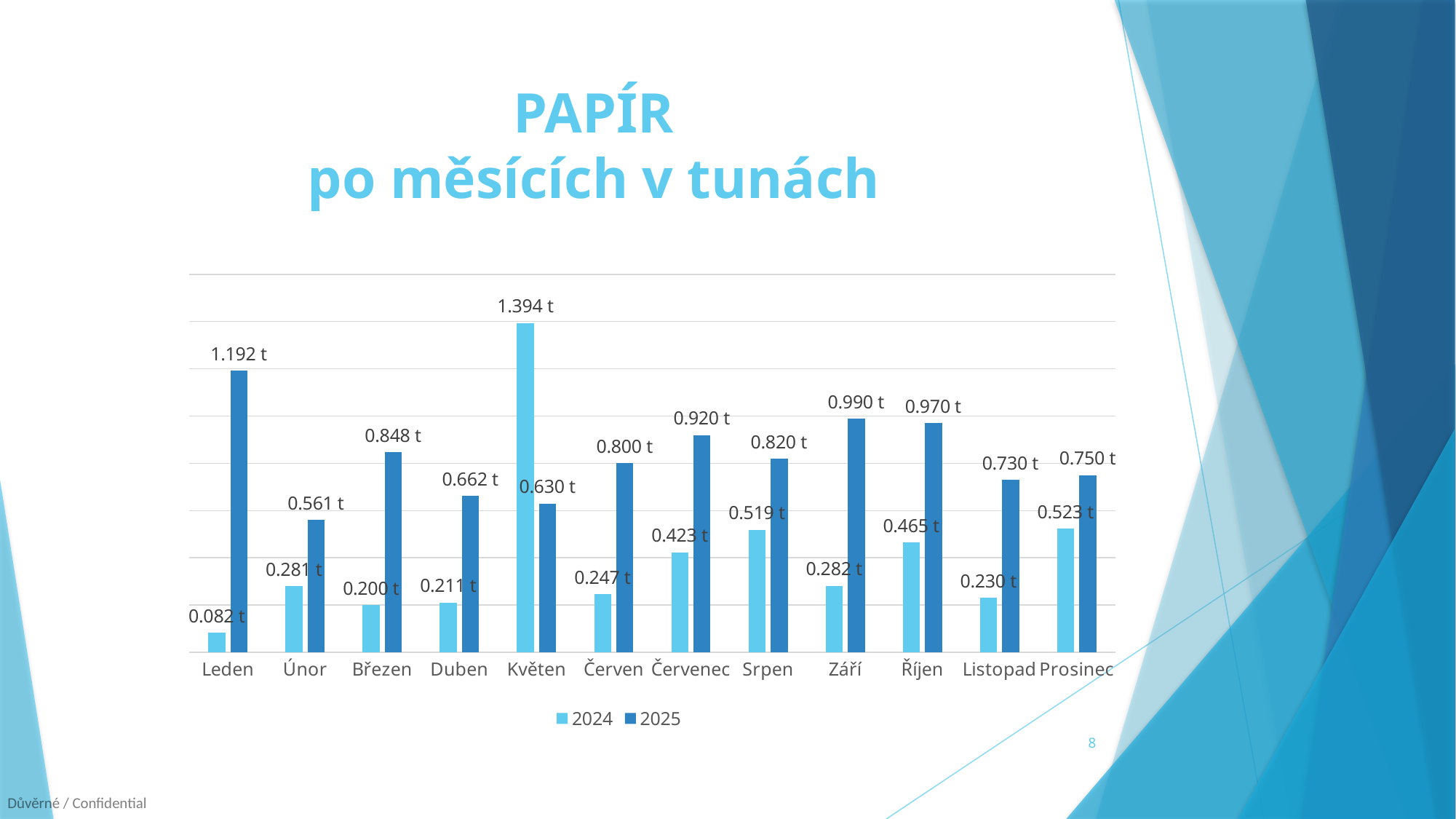
Which month has the lowest value in the 2024 series? Leden Which month has the lowest value in the 2025 series? Únor How many series does the legend list? 2 How many months are shown on the x axis? 12 What is the value for Květen in the 2024 series? 1.394 t Which month has the highest value in the 2024 series? Květen Which is larger for Květen: the 2024 value or the 2025 value? 2024 What is the value for Září in the 2025 series? 0.990 t Which month has the highest value in the 2025 series? Leden What is the value for Leden in the 2025 series? 1.192 t What is the difference between the 2025 and 2024 values for Leden? 1.110 t What is the value for Listopad in the 2024 series? 0.230 t